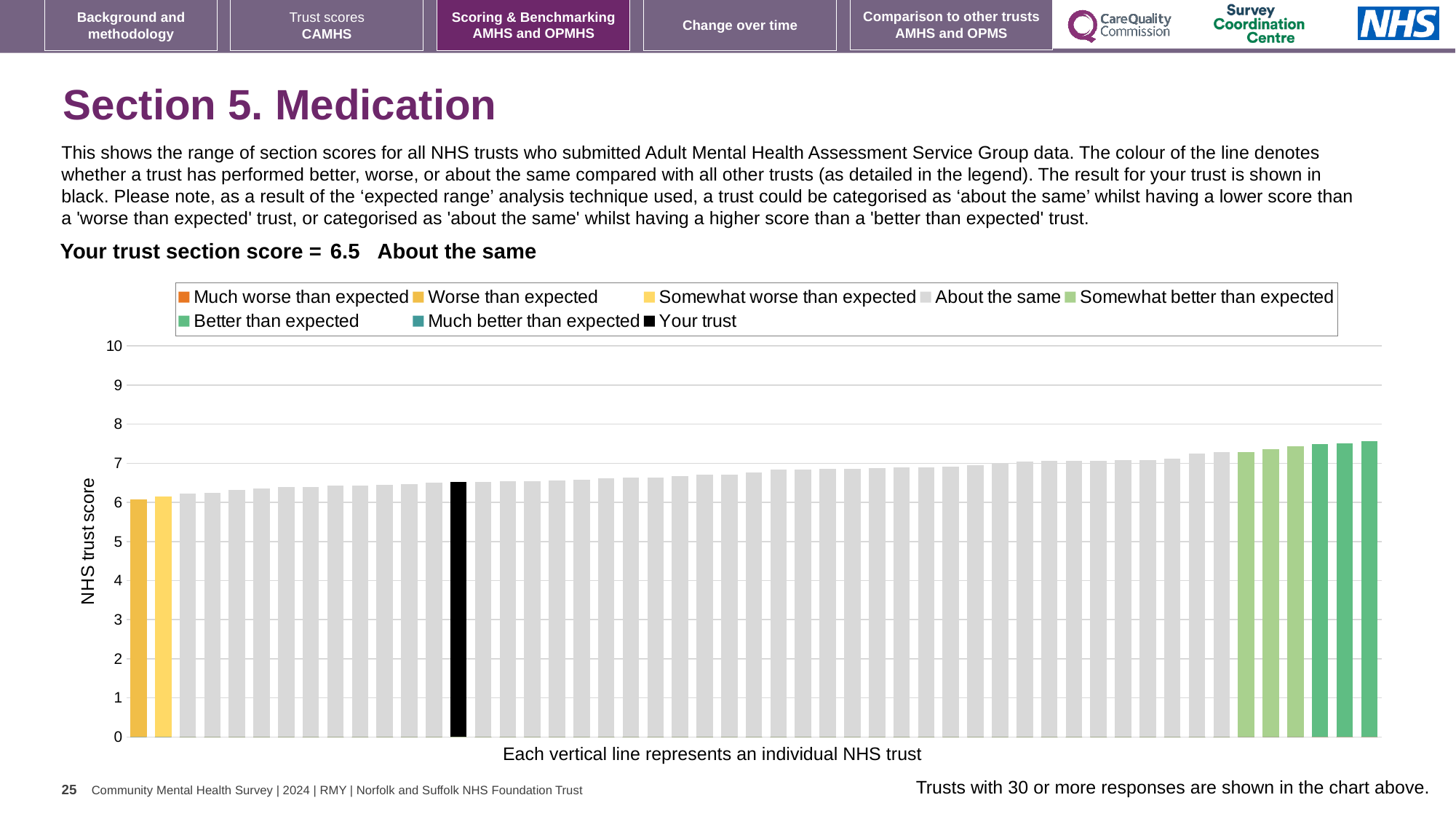
What is the label on the vertical axis of the chart? NHS trust score What is the section score for your trust shown on the slide? 6.5 Is the value of the shortest bar in the chart greater or less than 7? less Is the value for your trust greater or less than 5? greater What colour is the bar representing your trust? black How many entries does the chart legend list? 8 Which category is your trust's section score placed in? About the same How many bars are coloured as 'Worse than expected' (yellow)? 1 What is the highest value shown on the vertical axis? 10 Is the value of the tallest bar in the chart greater or less than 7? greater What kind of chart is shown on the slide? bar chart Do the bar values rise or fall from left to right across the chart? rise